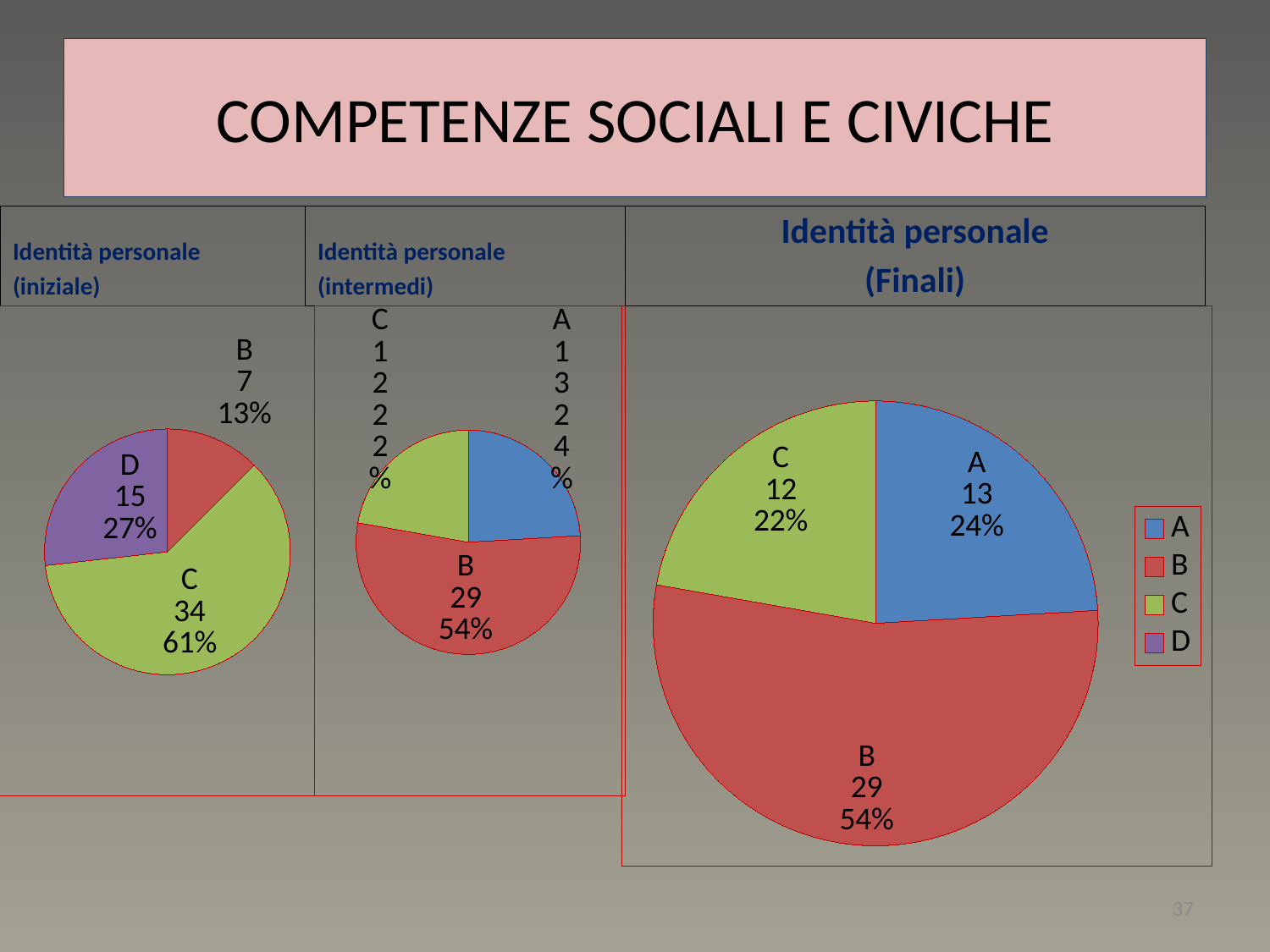
In the 'Identità personale (iniziale)' chart, what is the difference between the values for C and D? 19 In the 'Identità personale (Finali)' chart, what percentage is shown for category A? 24% In the 'Identità personale (Finali)' chart, what is the difference between the values for B and A? 16 In the 'Identità personale (Finali)' chart, which is larger, the value for A or the value for C? A How many entries does the legend next to the 'Identità personale (Finali)' chart list? 4 In the 'Identità personale (Finali)' chart, what value is shown for category C? 12 In the 'Identità personale (iniziale)' chart, what percentage is shown for category D? 27% In the 'Identità personale (iniziale)' chart, what value is shown for category C? 34 In the 'Identità personale (intermedi)' chart, which category has the largest slice? B In the 'Identità personale (iniziale)' chart, which category has the smallest slice? B In the 'Identità personale (iniziale)' chart, how many slices does the pie have? 3 In the 'Identità personale (intermedi)' chart, what value is shown for category B? 29